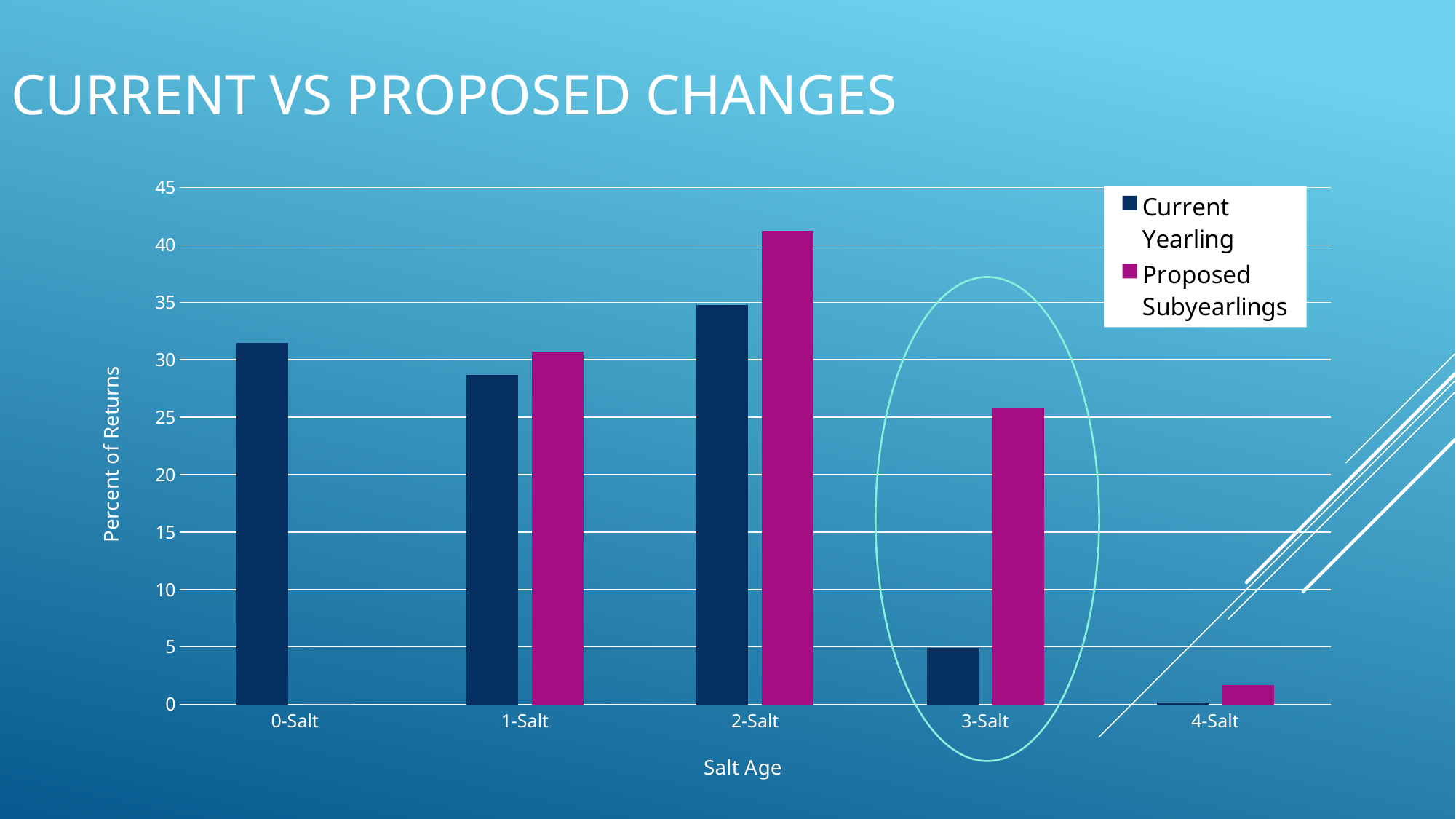
Is the Proposed Subyearlings value for 2-Salt greater or less than 40? greater What kind of chart is shown on the slide? bar chart How many series does the legend list? 2 Is the Current Yearling value for 3-Salt greater or less than 10? less For which salt age is the Current Yearling value lowest? 4-Salt For which salt age is the Proposed Subyearlings value highest? 2-Salt Is the Proposed Subyearlings value for 3-Salt greater or less than 20? greater What is the title of the y axis? Percent of Returns At 3-Salt, which series has the larger value, Current Yearling or Proposed Subyearlings? Proposed Subyearlings How many salt-age categories are shown on the x axis? 5 For which salt age is the Current Yearling value highest? 2-Salt For Current Yearling, which is larger, the value for 0-Salt or the value for 1-Salt? 0-Salt